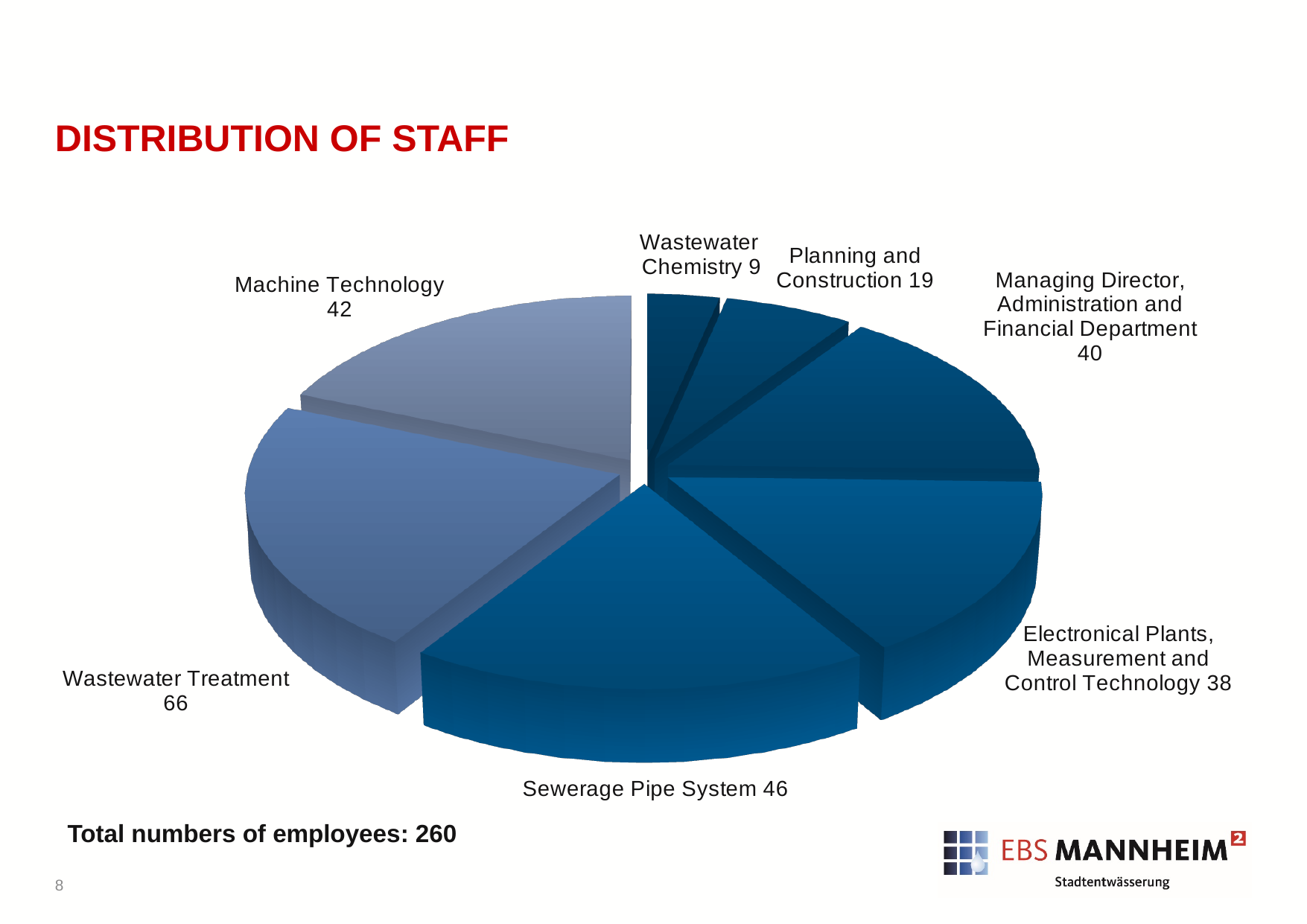
How many employees are in Electronical Plants, Measurement and Control Technology? 38 What is the difference in staff between Machine Technology and the Managing Director, Administration and Financial Department? 2 How many departments are shown in the pie chart? 7 How many employees are in Planning and Construction? 19 Which has more staff: Machine Technology or Electronical Plants, Measurement and Control Technology? Machine Technology Which department has the largest number of staff? Wastewater Treatment What is the total number of employees stated on the slide? 260 How many more employees does Wastewater Treatment have than the Sewerage Pipe System? 20 How many employees are in the Sewerage Pipe System? 46 How many employees are in Wastewater Treatment? 66 What kind of chart is shown on the slide? Pie chart Which department has the smallest number of staff? Wastewater Chemistry